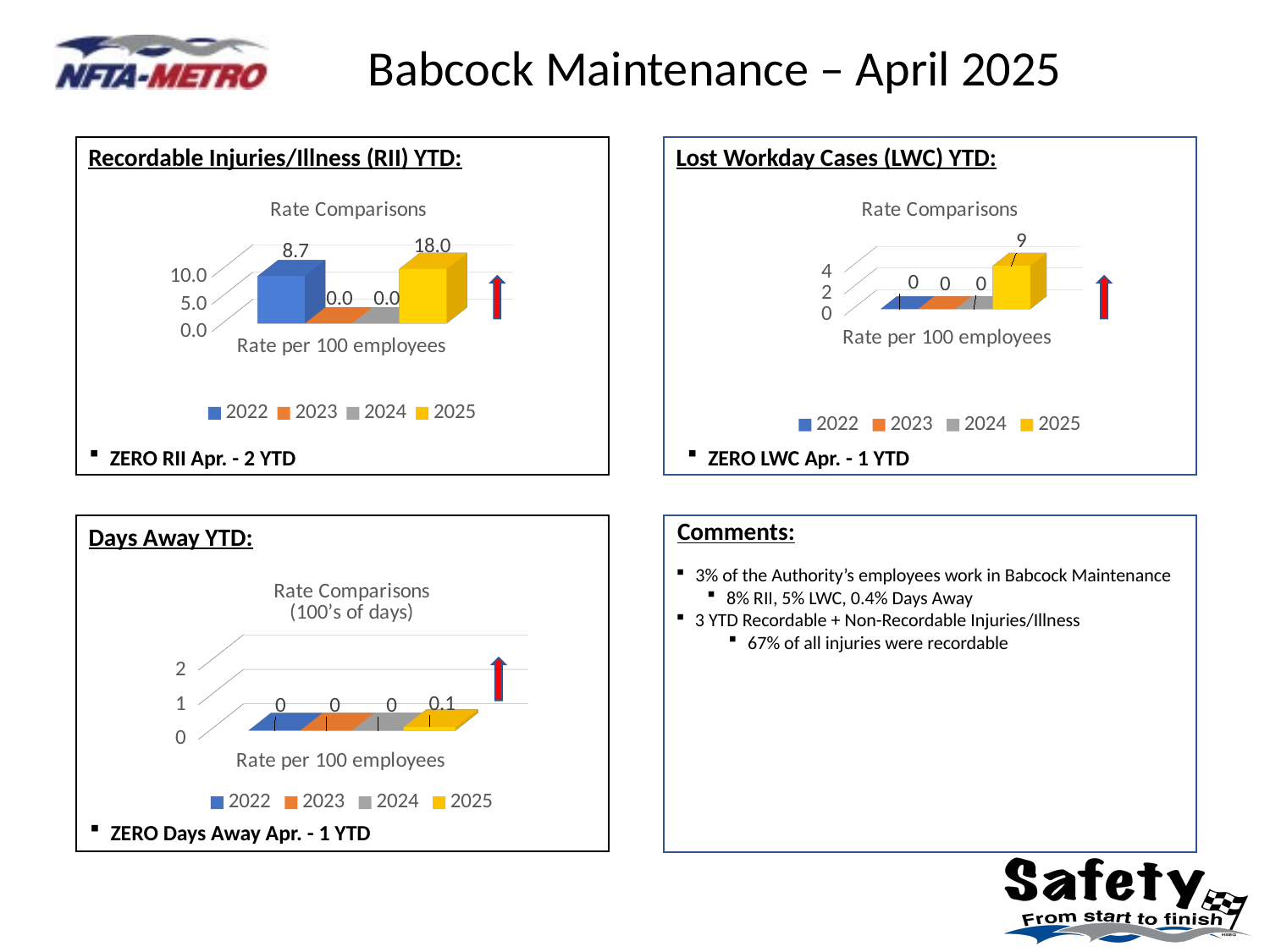
In the Days Away YTD chart, what is the value for 2025? 0.1 In the Days Away YTD chart, which year has the highest value? 2025 In the Lost Workday Cases (LWC) YTD chart, is the value for 2025 greater or less than 4? greater What kind of chart is the Lost Workday Cases (LWC) YTD chart? Bar chart In the Recordable Injuries/Illness (RII) YTD chart, which is larger, the value for 2022 or the value for 2025? 2025 In the Recordable Injuries/Illness (RII) YTD chart, what is the difference between the 2025 and 2022 values? 9.3 In the Recordable Injuries/Illness (RII) YTD chart, what is the value for 2022? 8.7 In the Lost Workday Cases (LWC) YTD chart, what is the value for 2025? 9 In the Recordable Injuries/Illness (RII) YTD chart, which year has the highest value? 2025 How many series does the legend list in the Days Away YTD chart? 4 In the Lost Workday Cases (LWC) YTD chart, what is the value for 2023? 0 In the Recordable Injuries/Illness (RII) YTD chart, what is the value for 2025? 18.0